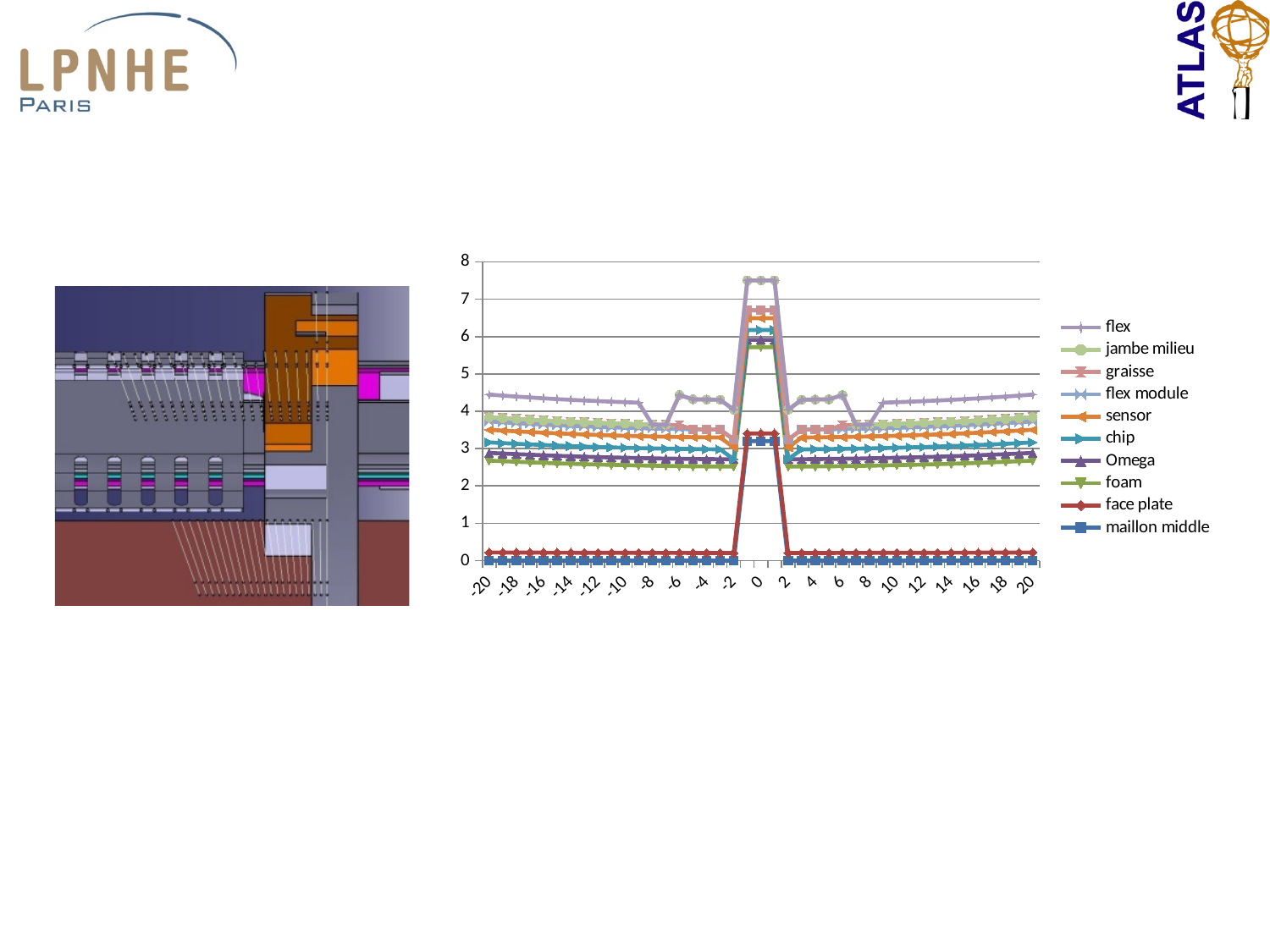
What kind of chart is shown on the slide? line chart Does the flex series rise or fall as x goes from 10 to 20? rise Which series is listed first in the legend? flex Which series has the lowest value at x = -20? maillon middle How many series does the legend list? 10 Is the value of the flex series at x = -20 greater or less than 4? greater Is the value of the foam series at x = 20 greater or less than 3? less How many labelled points are there along the x axis? 21 Is the value of the jambe milieu series at x = 0 greater or less than 7? greater At x = -20, which series has the larger value, flex or foam? flex